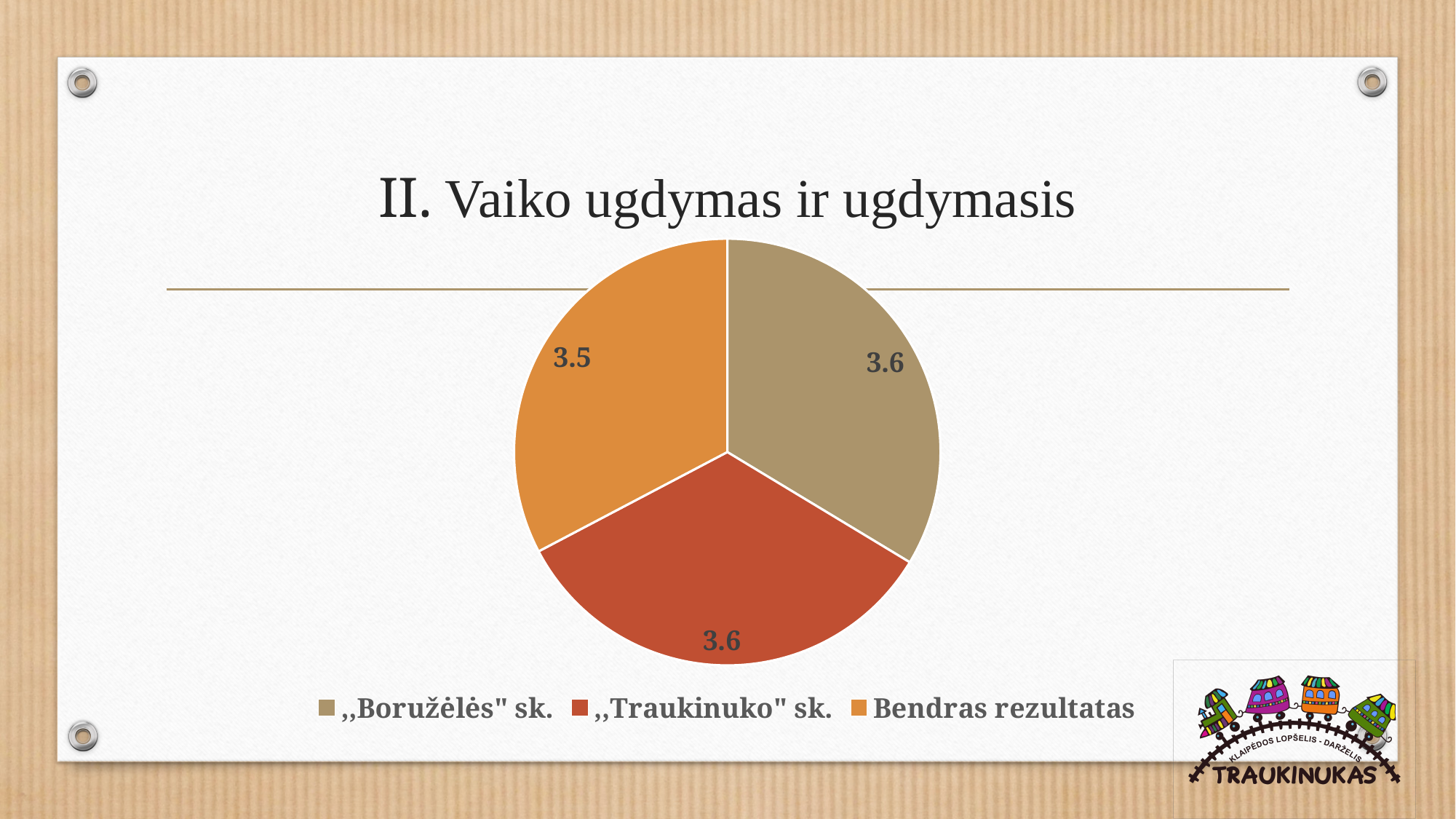
What is the value for Bendras rezultatas in the pie chart? 3.5 How many entries does the legend list? 3 Which legend entry is shown in orange? Bendras rezultatas What is the difference between the value for ,,Traukinuko" sk. and the value for Bendras rezultatas? 0.1 What is the value for ,,Traukinuko" sk. in the pie chart? 3.6 What kind of chart is shown on the slide? Pie chart Which category has the lowest value in the pie chart? Bendras rezultatas How many slices does the pie chart have? 3 What is the value for ,,Boružėlės" sk. in the pie chart? 3.6 What is the title of the slide containing the chart? II. Vaiko ugdymas ir ugdymasis Which is larger: the value for ,,Boružėlės" sk. or the value for Bendras rezultatas? ,,Boružėlės" sk. What is the sum of all three values shown in the pie chart? 10.7